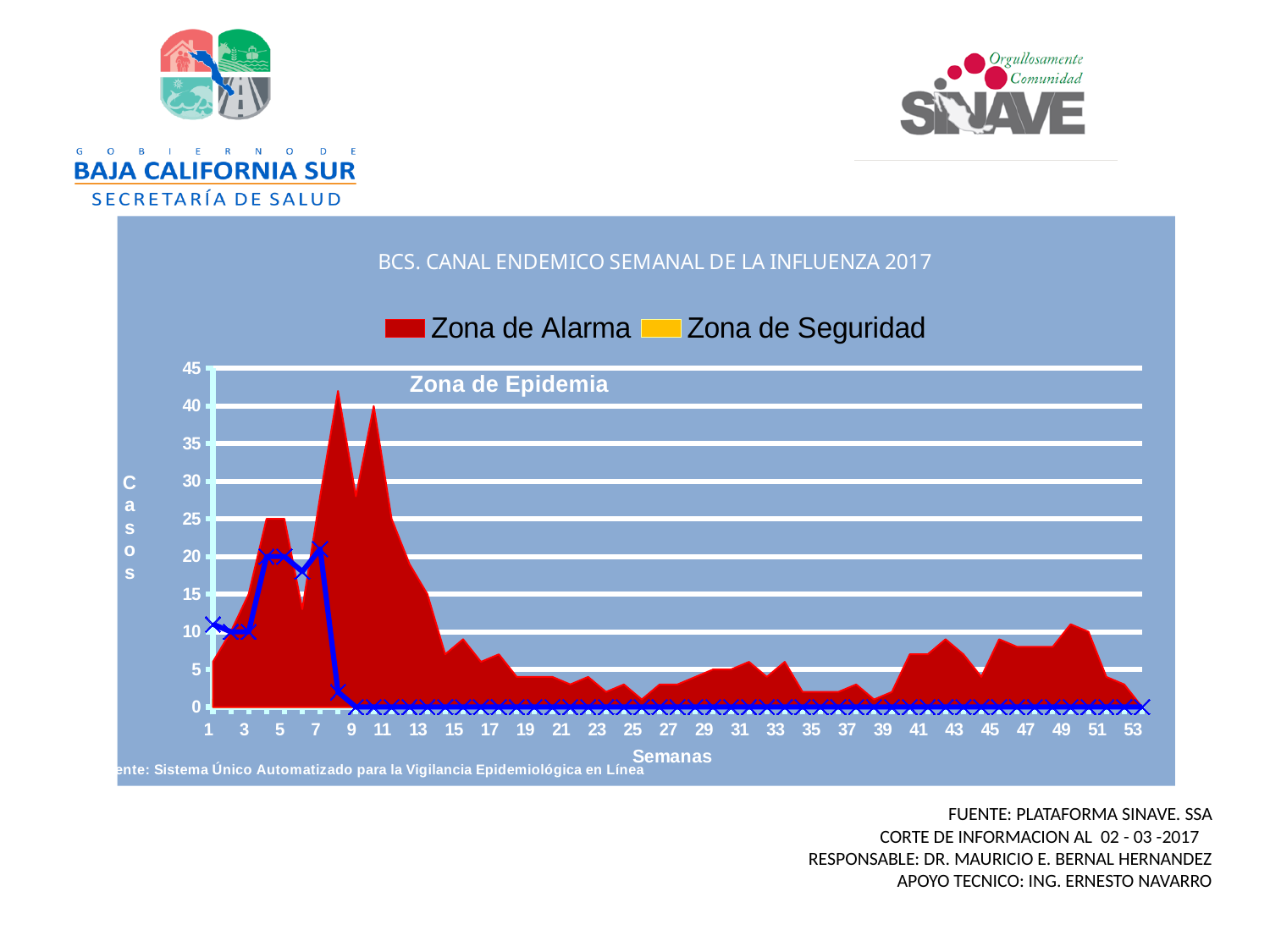
Is the value of the blue line at week 20 greater or less than 5? less Which is larger, the blue line value at week 5 or at week 3? week 5 Is the value of the red Zona de Alarma area at week 9 greater or less than 35? less How many weeks does the x axis span? 53 Is the value of the red Zona de Alarma area at week 30 greater or less than 10? less What kind of chart is shown on the slide? combination area and line chart Does the blue line rise or fall between week 8 and week 10? fall How many series does the chart legend list? 2 What is the title of the chart? BCS. CANAL ENDEMICO SEMANAL DE LA INFLUENZA 2017 What is the highest value shown on the y axis? 45 What text label appears inside the plot area above the red region? Zona de Epidemia